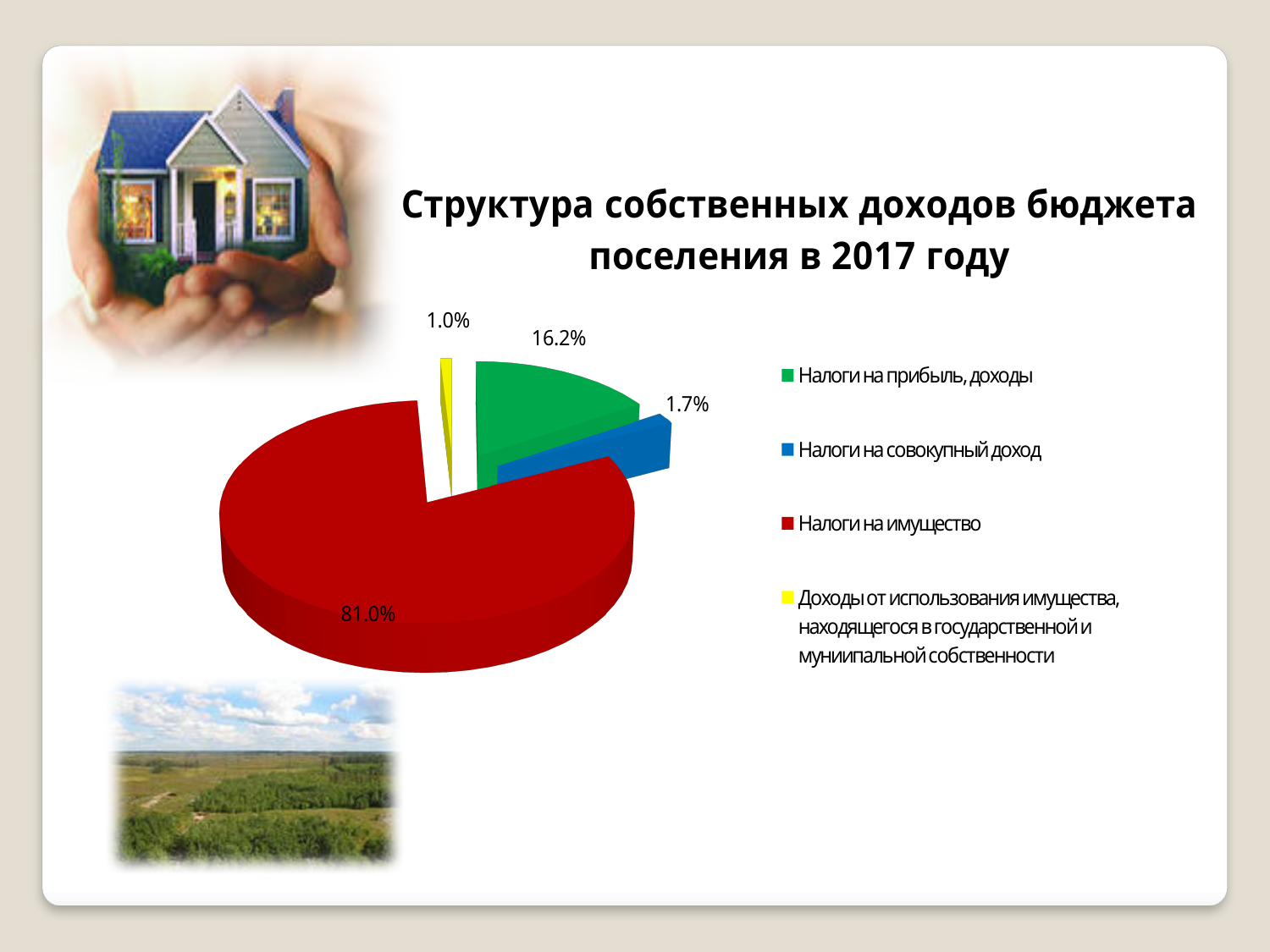
What share of the pie does "Налоги на совокупный доход" have? 1.7% How many categories does the pie chart have? 4 What colour is the slice for "Налоги на совокупный доход"? Blue Which is larger: the share of "Налоги на совокупный доход" or the share of "Налоги на прибыль, доходы"? Налоги на прибыль, доходы What is the difference between the shares of "Налоги на имущество" and "Налоги на прибыль, доходы"? 64.8% What is the title of the chart? Структура собственных доходов бюджета поселения в 2017 году What share of the pie does "Налоги на имущество" have? 81.0% What share of the pie does "Доходы от использования имущества, находящегося в государственной и мунииипальной собственности" have? 1.0% Which category has the smallest slice of the pie? Доходы от использования имущества, находящегося в государственной и муниипальной собственности What type of chart is shown on the slide? Pie chart Which category has the largest slice of the pie? Налоги на имущество